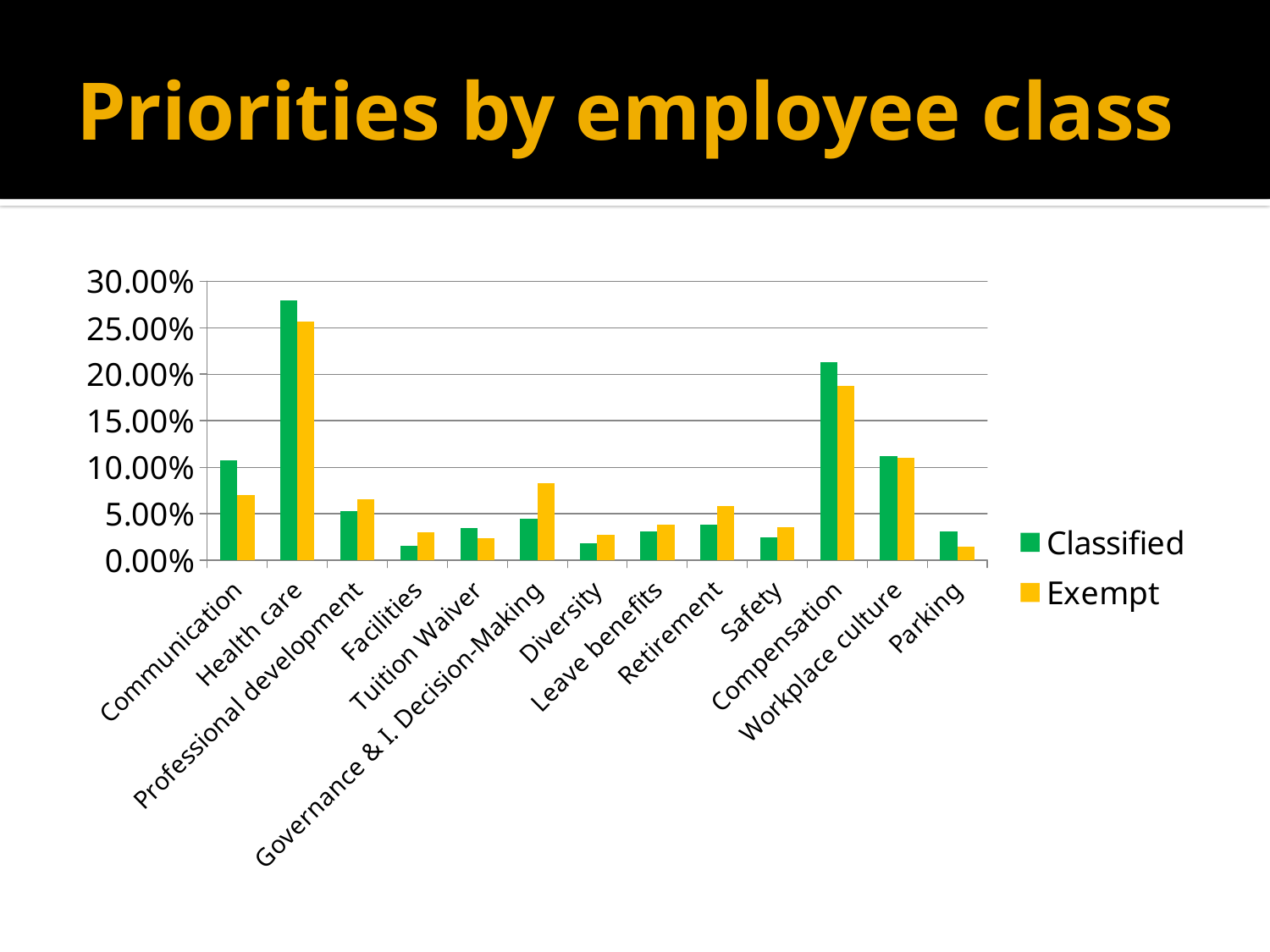
Which colour represents the Exempt series in the legend? yellow Which category has the highest Classified value? Health care Is the Exempt value for Compensation greater or less than 20.00%? less For Communication, which series has the larger value, Classified or Exempt? Classified Which category has the highest Exempt value? Health care For Governance & I. Decision-Making, which series has the larger value, Classified or Exempt? Exempt How many categories are shown on the x axis? 13 Is the Classified value for Communication greater or less than 10.00%? greater How many series does the legend list? 2 Is the Classified value for Health care greater or less than 25.00%? greater What kind of chart is shown on the slide? bar chart Which category has the lowest Exempt value? Parking